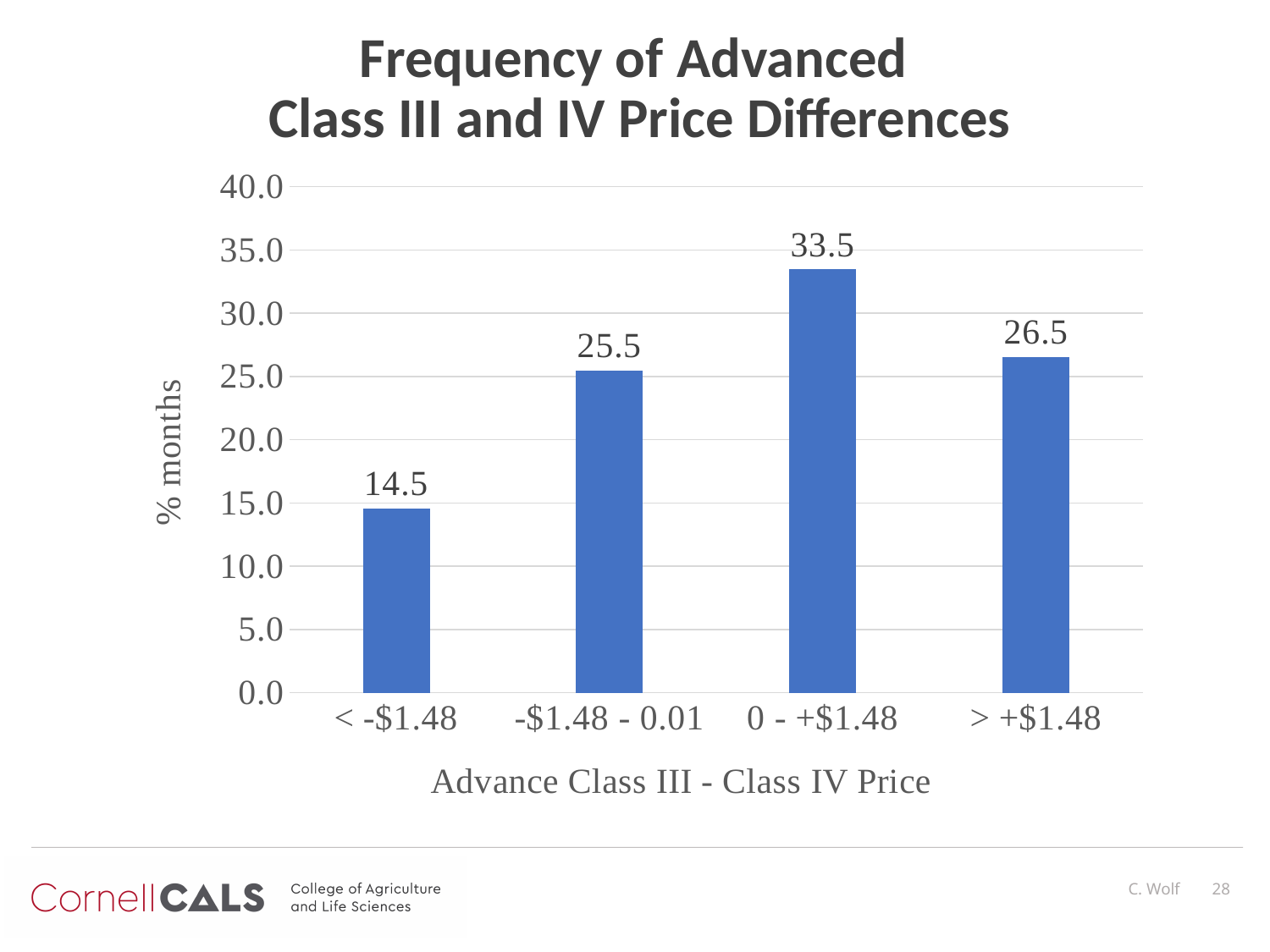
What is the label of the y axis? % months Which category has the highest value? 0 - +$1.48 Which category has the lowest value? < -$1.48 What is the difference between the values for "> +$1.48" and "-$1.48 - 0.01"? 1.0 Which is larger, the value for "-$1.48 - 0.01" or the value for "> +$1.48"? > +$1.48 How many categories are shown on the x axis? 4 Is the value for "0 - +$1.48" greater or less than 30.0? greater What is the value for the "< -$1.48" category? 14.5 What is the difference between the values for "0 - +$1.48" and "< -$1.48"? 19.0 What is the value for the "> +$1.48" category? 26.5 What is the value for the "0 - +$1.48" category? 33.5 What kind of chart is shown on the slide? bar chart